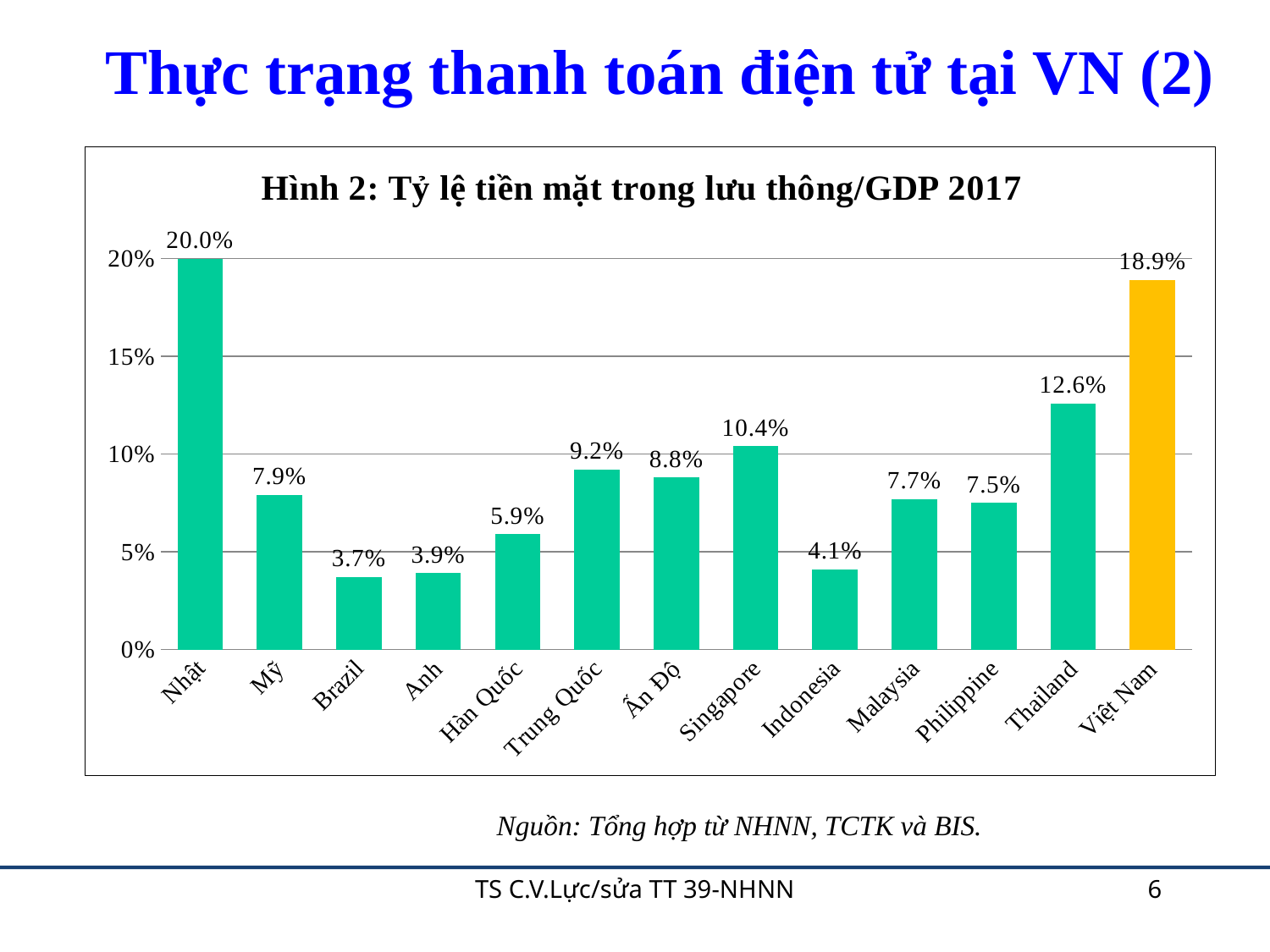
Is the value for Indonesia greater or less than 5%? less Which is larger, the value for Trung Quốc or the value for Ấn Độ? Trung Quốc What is the value for Singapore? 10.4% How many countries are shown on the chart? 13 Which country has the highest value? Nhật Which country has the lowest value? Brazil What is the difference between the values for Thailand and Malaysia? 4.9% What is the title of the chart? Hình 2: Tỷ lệ tiền mặt trong lưu thông/GDP 2017 What kind of chart is shown? bar chart What is the value for Việt Nam? 18.9% What is the value for Hàn Quốc? 5.9% What is the difference between the values for Nhật and Việt Nam? 1.1%